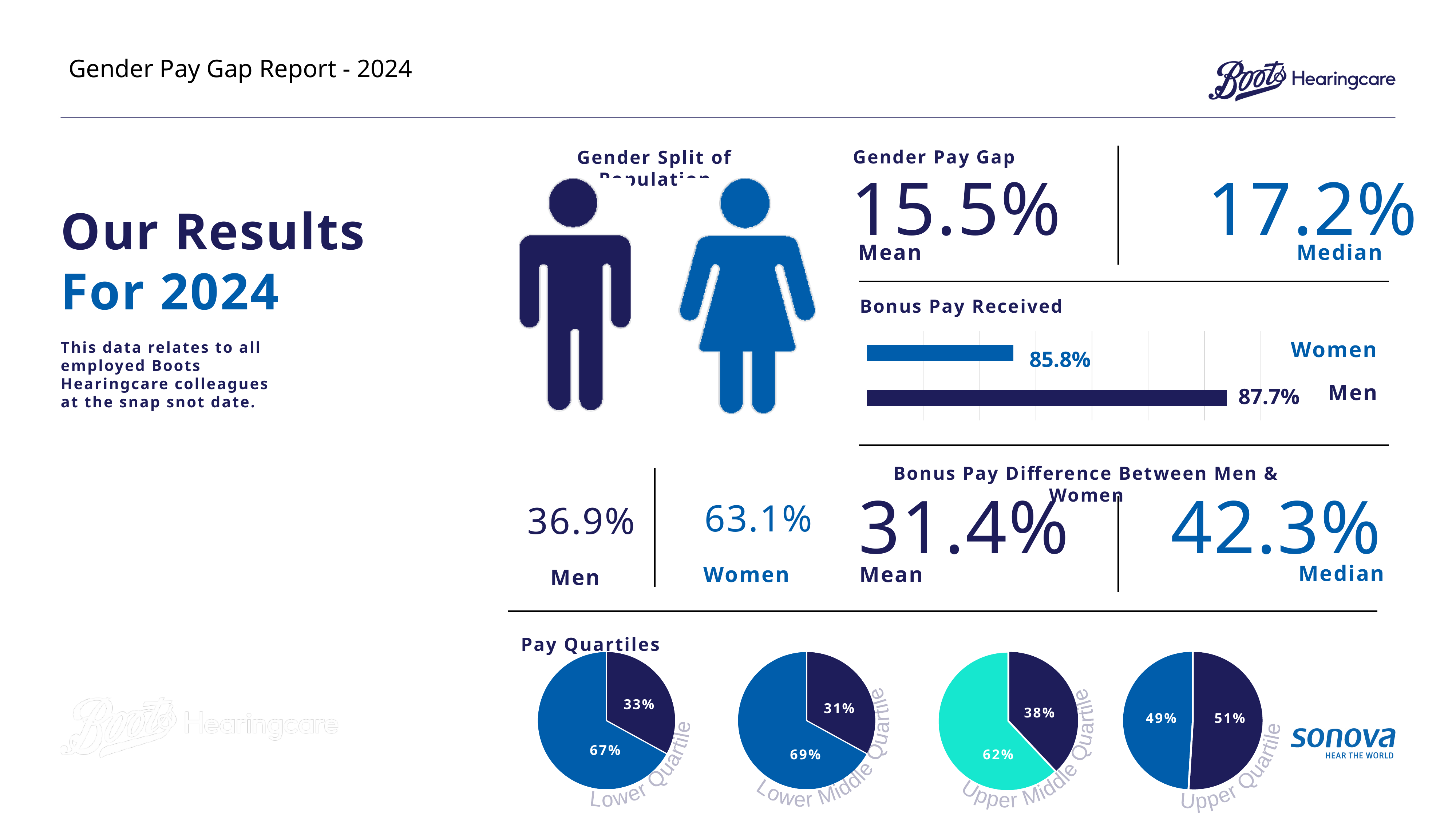
What kind of chart is the Bonus Pay Received chart? Bar chart In the Bonus Pay Received chart, what percentage of men received bonus pay? 87.7% In the Lower Middle Quartile pie chart, what is the value of the larger slice? 69% How many bars are shown in the Bonus Pay Received chart? 2 Across the four Pay Quartiles pie charts, which quartile has the largest dark navy slice? Upper Quartile In the Bonus Pay Received chart, which group has the higher value, Women or Men? Men In the Bonus Pay Received chart, what percentage of women received bonus pay? 85.8% In the Upper Middle Quartile pie chart, what is the value of the teal slice? 62% How many pie charts are shown under Pay Quartiles? 4 In the Bonus Pay Received chart, what is the difference between the Men and Women values? 1.9% In the Upper Quartile pie chart, what is the value of the dark navy slice? 51% In the Lower Quartile pie chart, what is the value of the dark navy slice? 33%